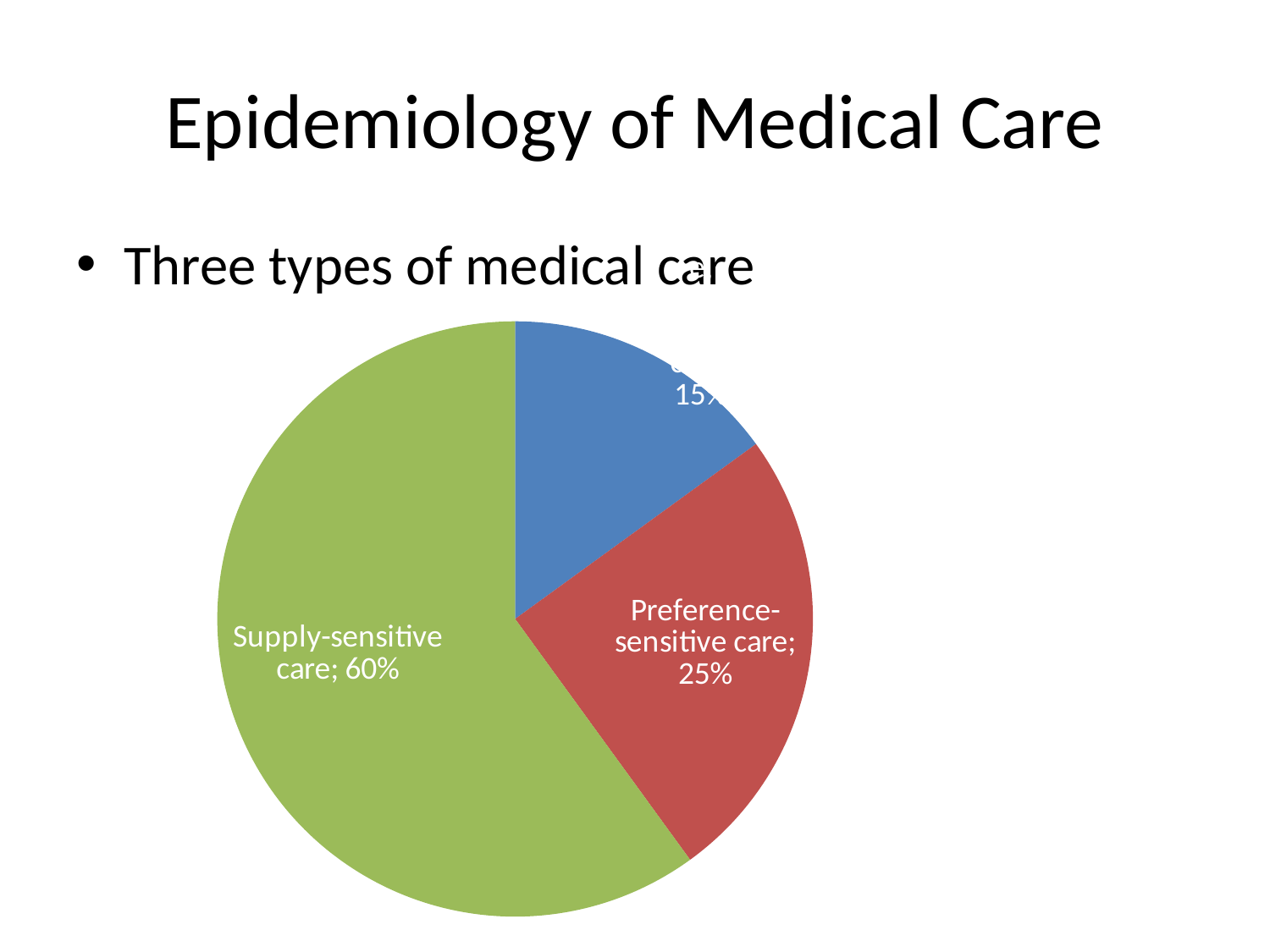
What share of the pie is Supply-sensitive care? 60% What share of the pie is Preference-sensitive care? 25% What colour is the Supply-sensitive care slice? green How many slices does the pie chart have? 3 Which is larger, Supply-sensitive care or Preference-sensitive care? Supply-sensitive care What colour is the Preference-sensitive care slice? red How many percentage points larger is Supply-sensitive care than Preference-sensitive care? 35 Is the share for Supply-sensitive care greater or less than 50%? greater What colour is the smallest slice of the pie? blue Is the share for Preference-sensitive care greater or less than 30%? less What kind of chart is shown on the slide? pie chart Which category has the largest slice of the pie? Supply-sensitive care